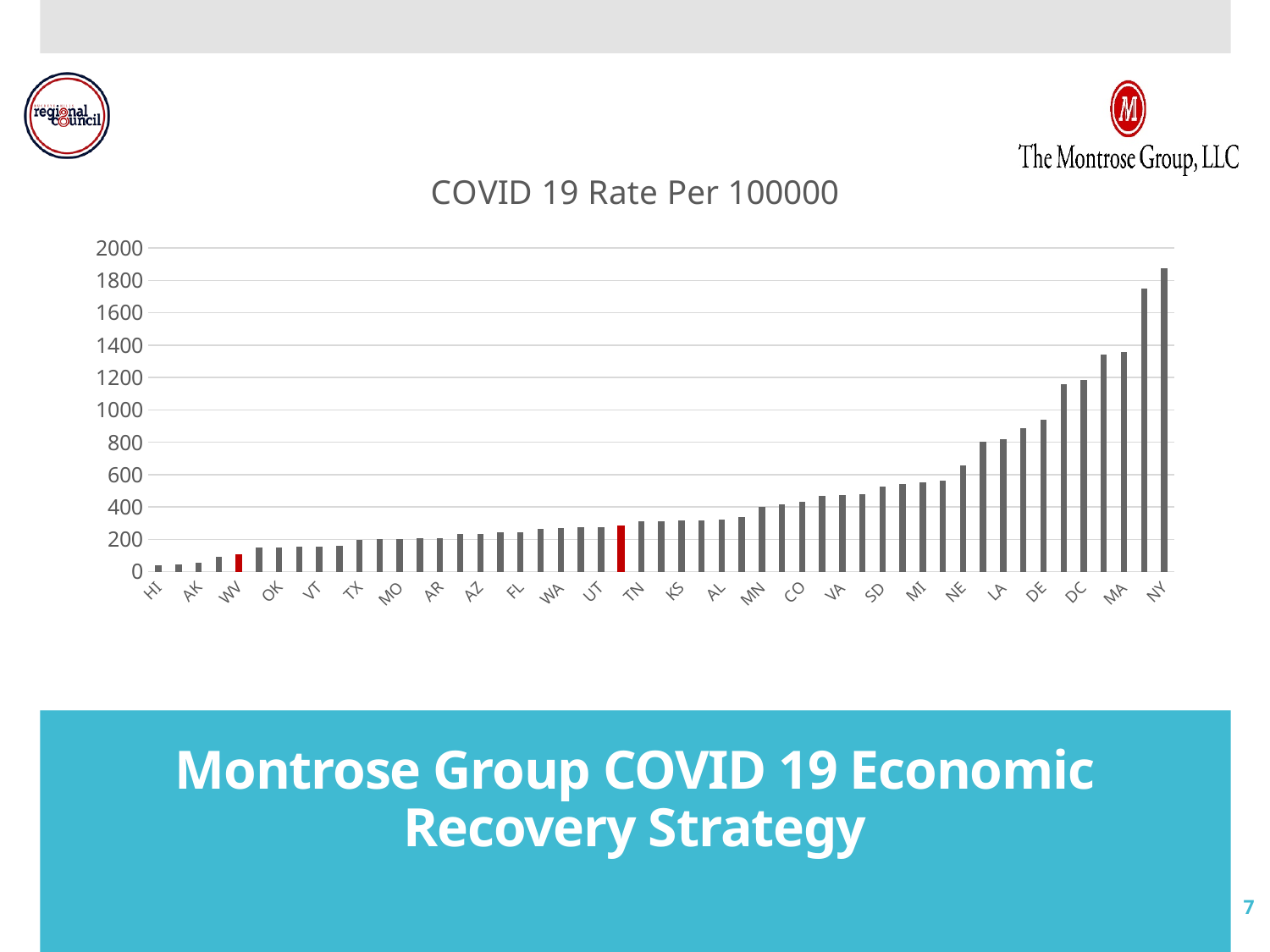
Which state has the highest COVID 19 rate per 100000 in the chart? NY Which has a higher COVID 19 rate per 100000, DC or TN? DC What kind of chart is shown on the slide? bar chart Is the value for NY greater or less than 1800? greater Which state has the lowest COVID 19 rate per 100000 in the chart? HI What is the title of the chart? COVID 19 Rate Per 100000 Is the value for TN greater or less than 200? greater Is the value for MA greater or less than 1600? less Do the values generally rise or fall moving from left to right along the x axis? rise